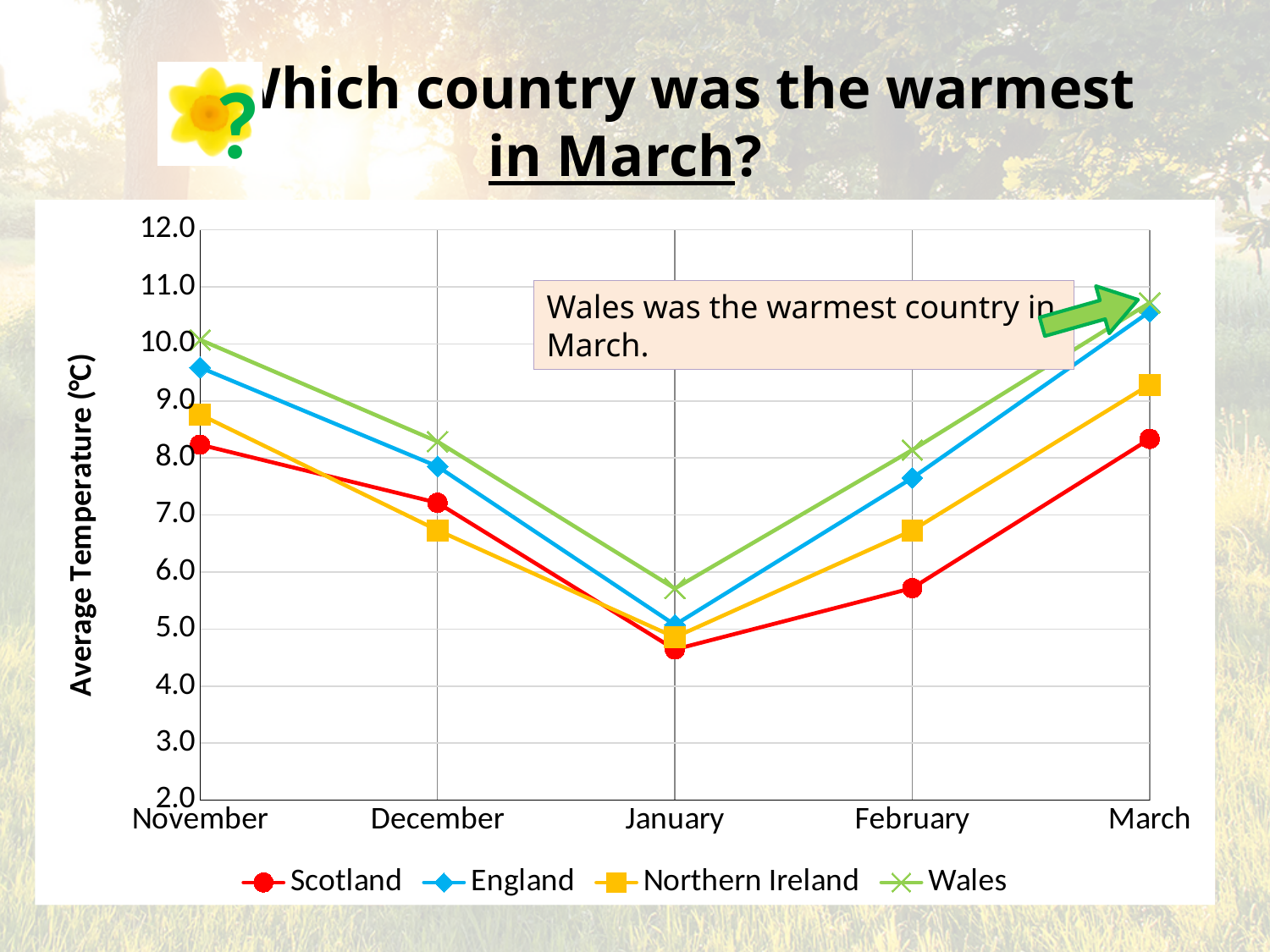
In which month was Scotland's average temperature lowest? January Which country was the warmest in March? Wales Do the average temperatures rise or fall from November to January? fall How many series does the legend list? 4 What is the title of the y axis? Average Temperature (°C) Is the value for Wales in November greater or less than 9.0? greater In February, which had the higher average temperature, Scotland or Northern Ireland? Northern Ireland Is the value for Scotland in February greater or less than 6.0? less What kind of chart is shown on the slide? line chart Is the value for England in January greater or less than 6.0? less How many months are shown along the x axis? 5 Which country had the lowest average temperature in February? Scotland